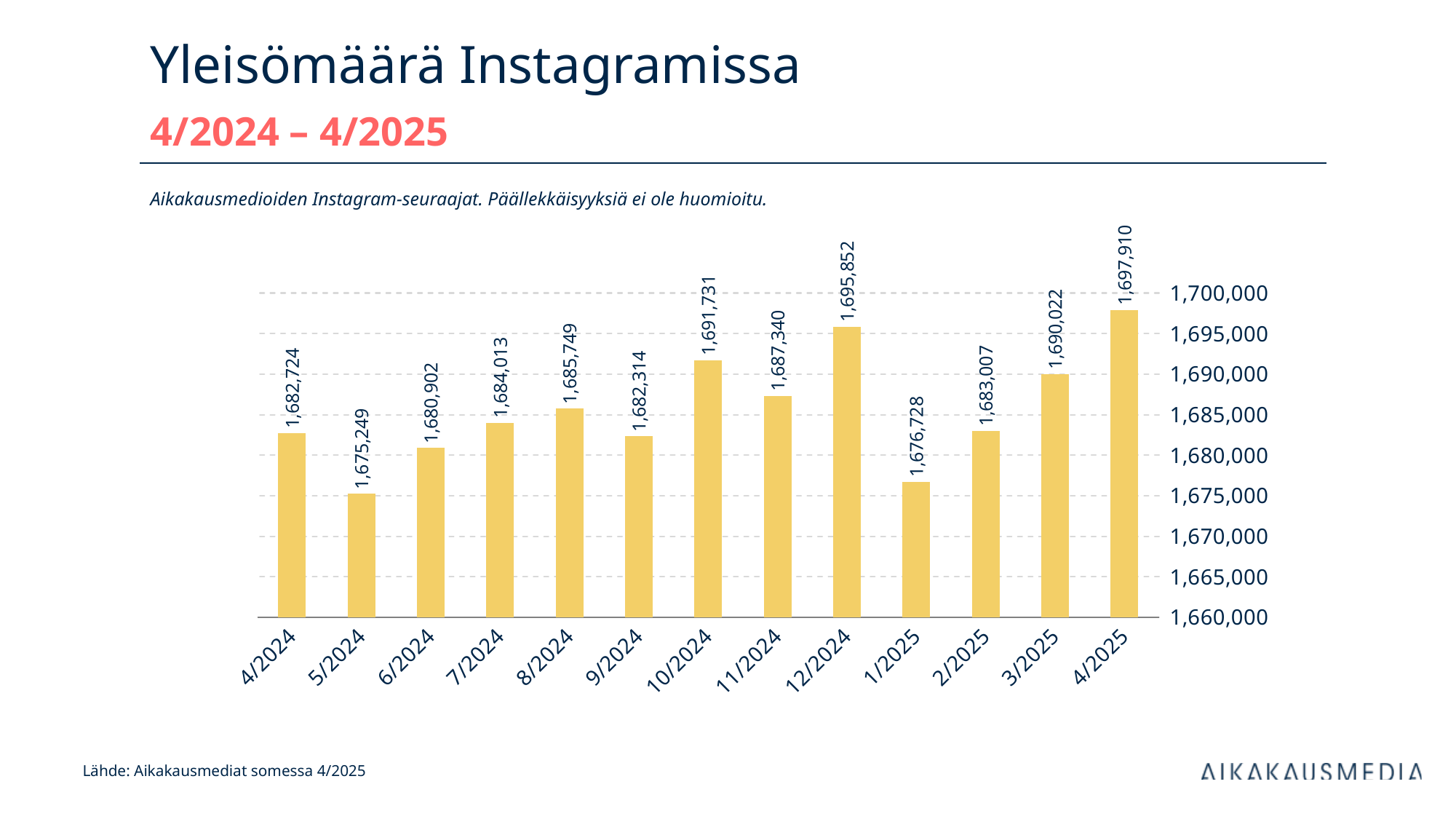
What is the difference between the values for 4/2025 and 4/2024? 15,186 How many months are shown on the x axis? 13 Is the value for 3/2025 greater or less than 1,685,000? greater What is the value for 12/2024? 1,695,852 What is the value for 10/2024? 1,691,731 Which month has the lowest value? 5/2024 What is the value for 4/2024? 1,682,724 What is the difference between the values for 12/2024 and 1/2025? 19,124 Which is larger, the value for 8/2024 or the value for 11/2024? 11/2024 What is the value for 1/2025? 1,676,728 Which month has the highest value? 4/2025 What kind of chart is shown on the slide? bar chart